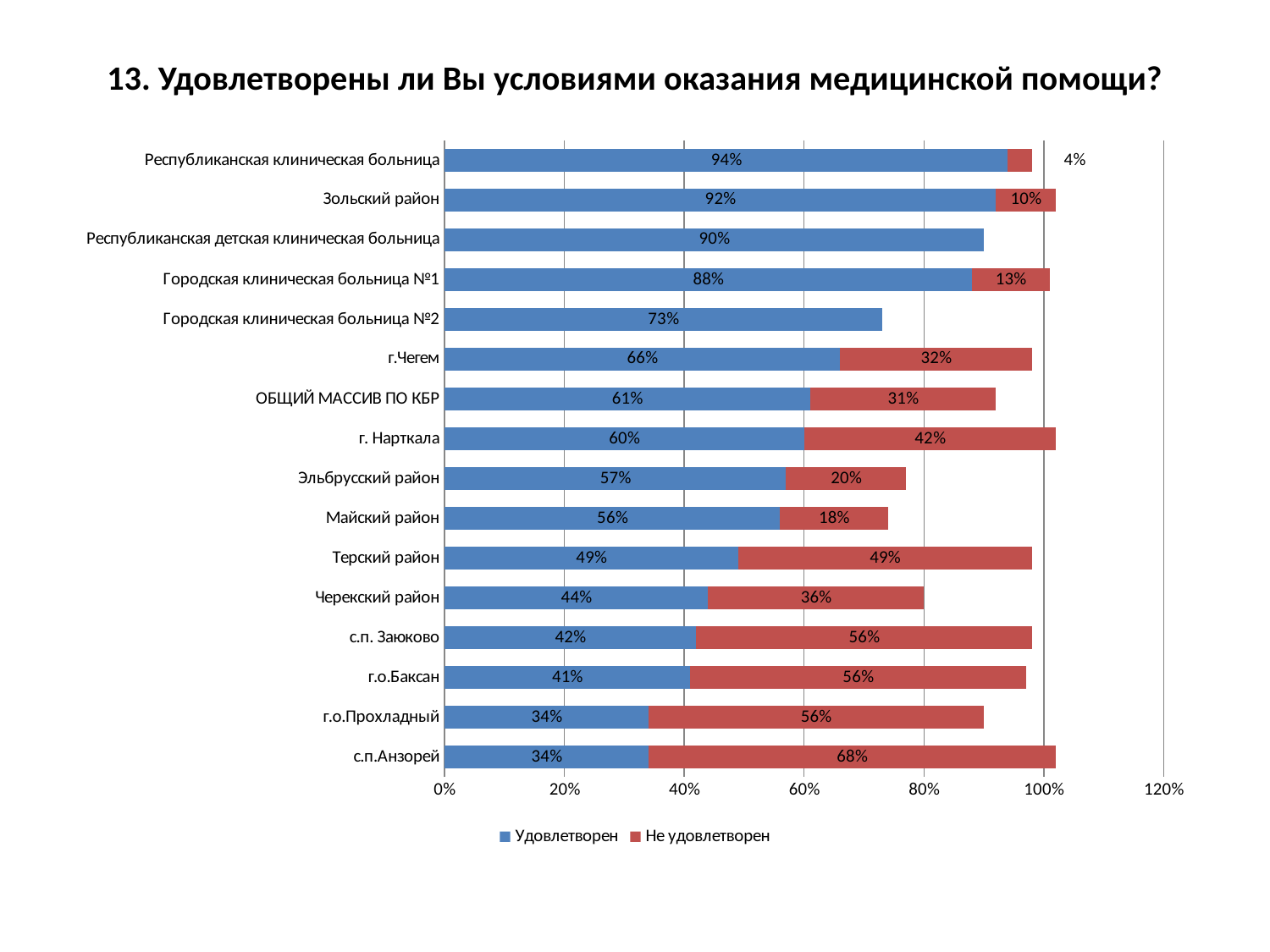
How many series does the legend list? 2 What is the Не удовлетворен value for г. Нарткала? 42% How many categories are shown on the chart? 16 Which category has the lowest Не удовлетворен value among those with a printed label? Республиканская клиническая больница What is the total of the stacked bar for Майский район? 74% Which category has the highest Удовлетворен value? Республиканская клиническая больница What kind of chart is shown on the slide? Stacked bar chart Which category has the highest Не удовлетворен value? с.п.Анзорей Which is larger: the Не удовлетворен value for Черекский район or for Эльбрусский район? Черекский район What is the difference between the Удовлетворен values for г.Чегем and Терский район? 17% What is the Удовлетворен value for ОБЩИЙ МАССИВ ПО КБР? 61% What is the Удовлетворен value for Зольский район? 92%